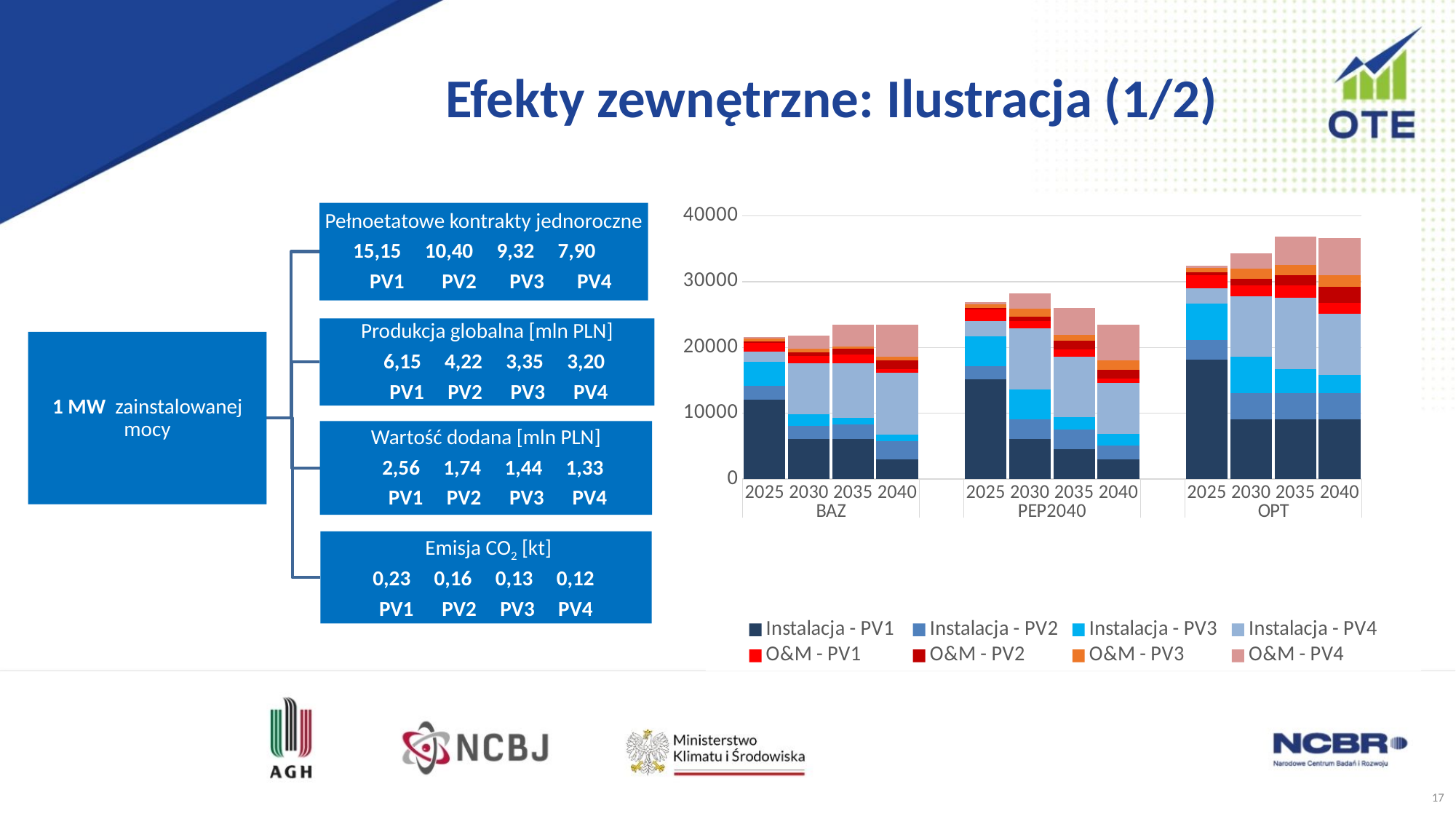
Is the total height of the 2035 bar in the OPT group greater or less than 30000? greater Which scenario group has the tallest stacked bars in the chart? OPT Is the total height of the 2040 bar in the BAZ group greater or less than 20000? greater Which bar is taller: 2030 in the PEP2040 group or 2030 in the BAZ group? 2030 in the PEP2040 group How many series does the chart legend list? 8 Which bar is taller: 2025 in the OPT group or 2025 in the BAZ group? 2025 in the OPT group How many scenario groups (BAZ, PEP2040, OPT) are shown on the x axis of the chart? 3 Is the Instalacja - PV1 segment of the 2025 bar in the OPT group greater or less than 10000? greater How many bars are plotted in the chart in total? 12 Within the BAZ group, does the Instalacja - PV1 segment rise or fall from 2025 to 2040? fall What kind of chart is shown on the right side of the slide? stacked bar chart